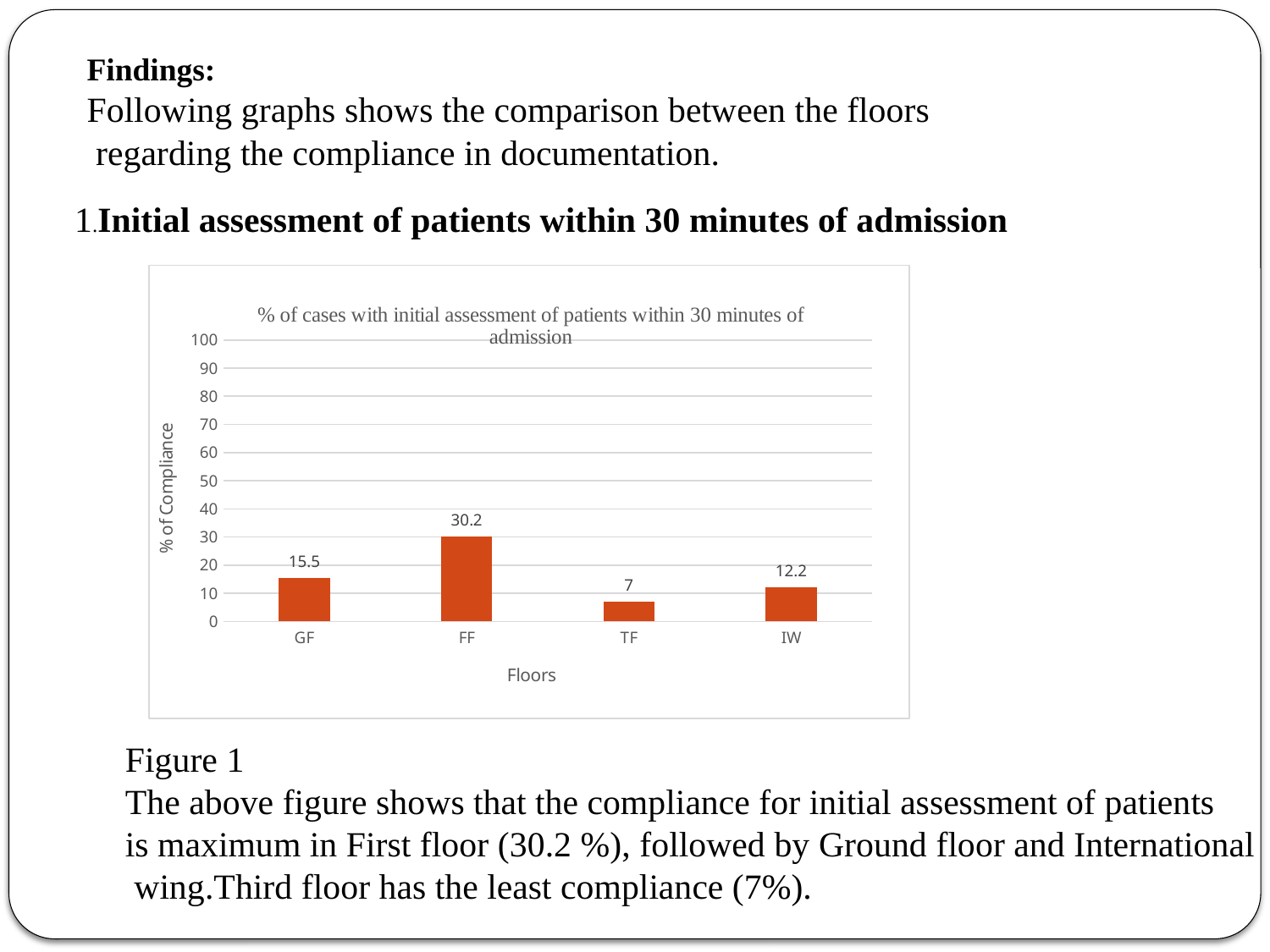
What is the difference between the values for IW and TF? 5.2 Which floor has the lowest % of compliance? TF What is the value for IW in the chart? 12.2 Which floor has the highest % of compliance? FF What is the label of the y axis of the chart? % of Compliance What is the value for GF in the chart? 15.5 Which is larger, the value for GF or the value for IW? GF What is the difference between the values for FF and GF? 14.7 What is the value for FF in the chart? 30.2 How many floors are shown on the x axis of the chart? 4 What kind of chart is shown on the slide? Bar chart What is the value for TF in the chart? 7